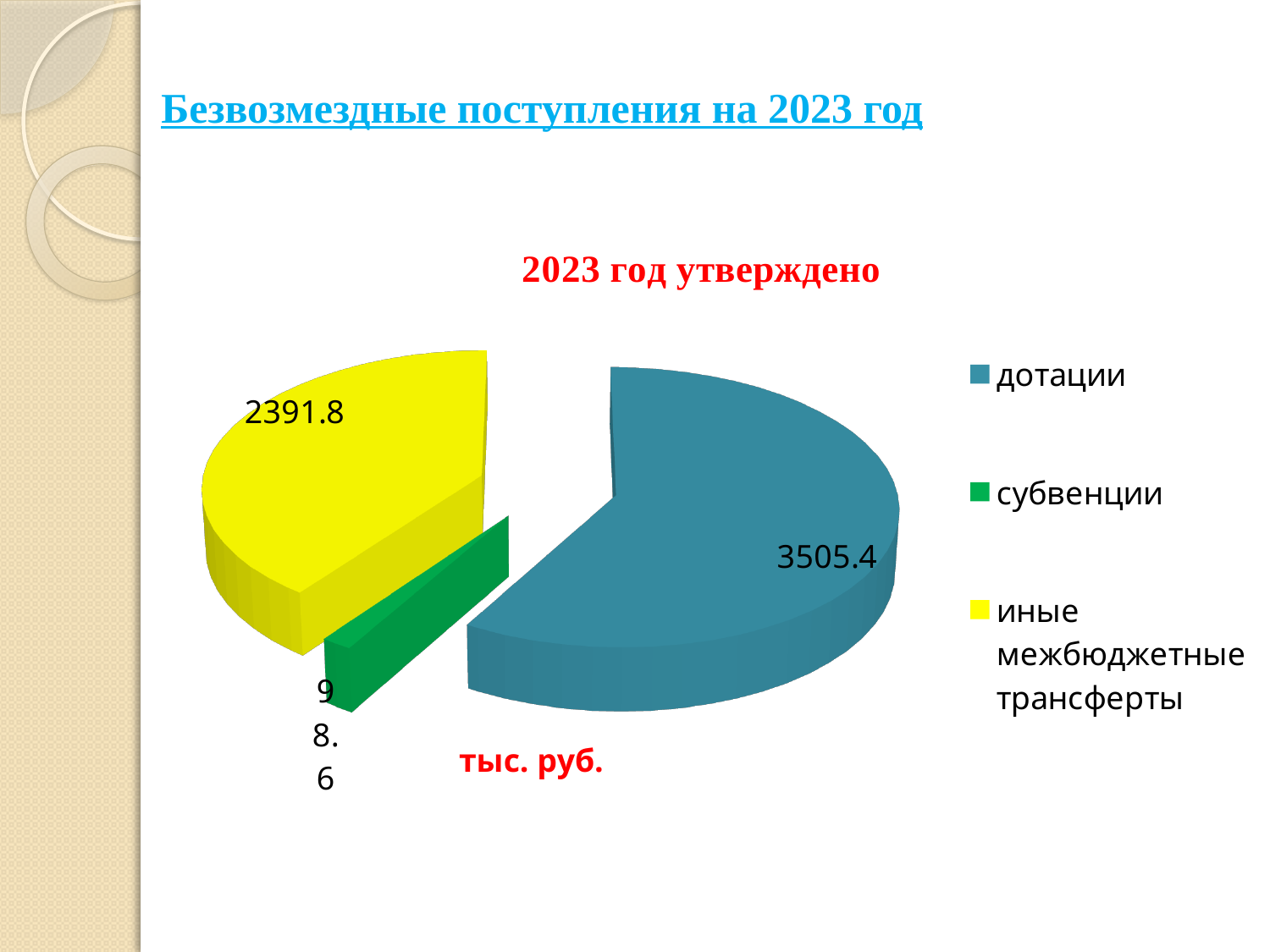
What is the value for субвенции in the pie chart? 98.6 How many categories does the pie chart show? 3 What type of chart is shown on the slide? pie chart What unit is indicated below the pie chart? тыс. руб. What is the difference between the values for иные межбюджетные трансферты and субвенции? 2293.2 Which category has the largest slice in the pie chart? дотации What is the value for дотации in the pie chart? 3505.4 What is the title of the pie chart? 2023 год утверждено What is the difference between the values for дотации and иные межбюджетные трансферты? 1113.6 Which category has the smallest slice in the pie chart? субвенции What is the value for иные межбюджетные трансферты in the pie chart? 2391.8 Which is larger, the value for дотации or the value for иные межбюджетные трансферты? дотации